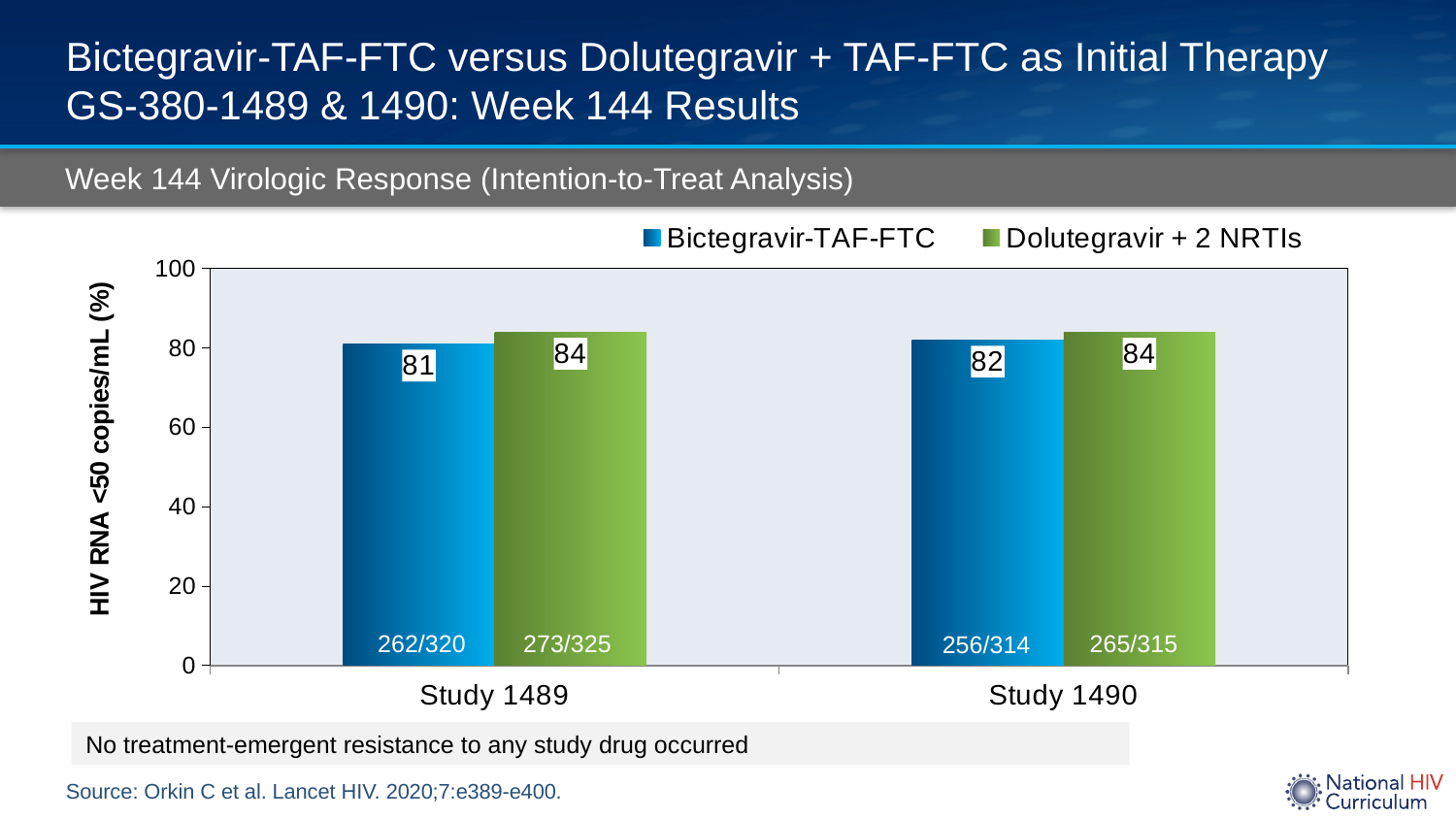
What is the value for Bictegravir-TAF-FTC in Study 1489? 81 What fraction of participants is shown for Dolutegravir + 2 NRTIs in Study 1489? 273/325 How many series does the legend list? 2 What is the label of the y axis? HIV RNA <50 copies/mL (%) Is the value for Bictegravir-TAF-FTC in Study 1489 greater or less than 60? greater What is the value for Bictegravir-TAF-FTC in Study 1490? 82 What is the value for Dolutegravir + 2 NRTIs in Study 1490? 84 What kind of chart is shown? Bar chart What is the difference between the Dolutegravir + 2 NRTIs and Bictegravir-TAF-FTC values in Study 1490? 2 How many study categories are shown on the x axis? 2 What fraction of participants is shown for Bictegravir-TAF-FTC in Study 1490? 256/314 What is the difference between the Dolutegravir + 2 NRTIs and Bictegravir-TAF-FTC values in Study 1489? 3